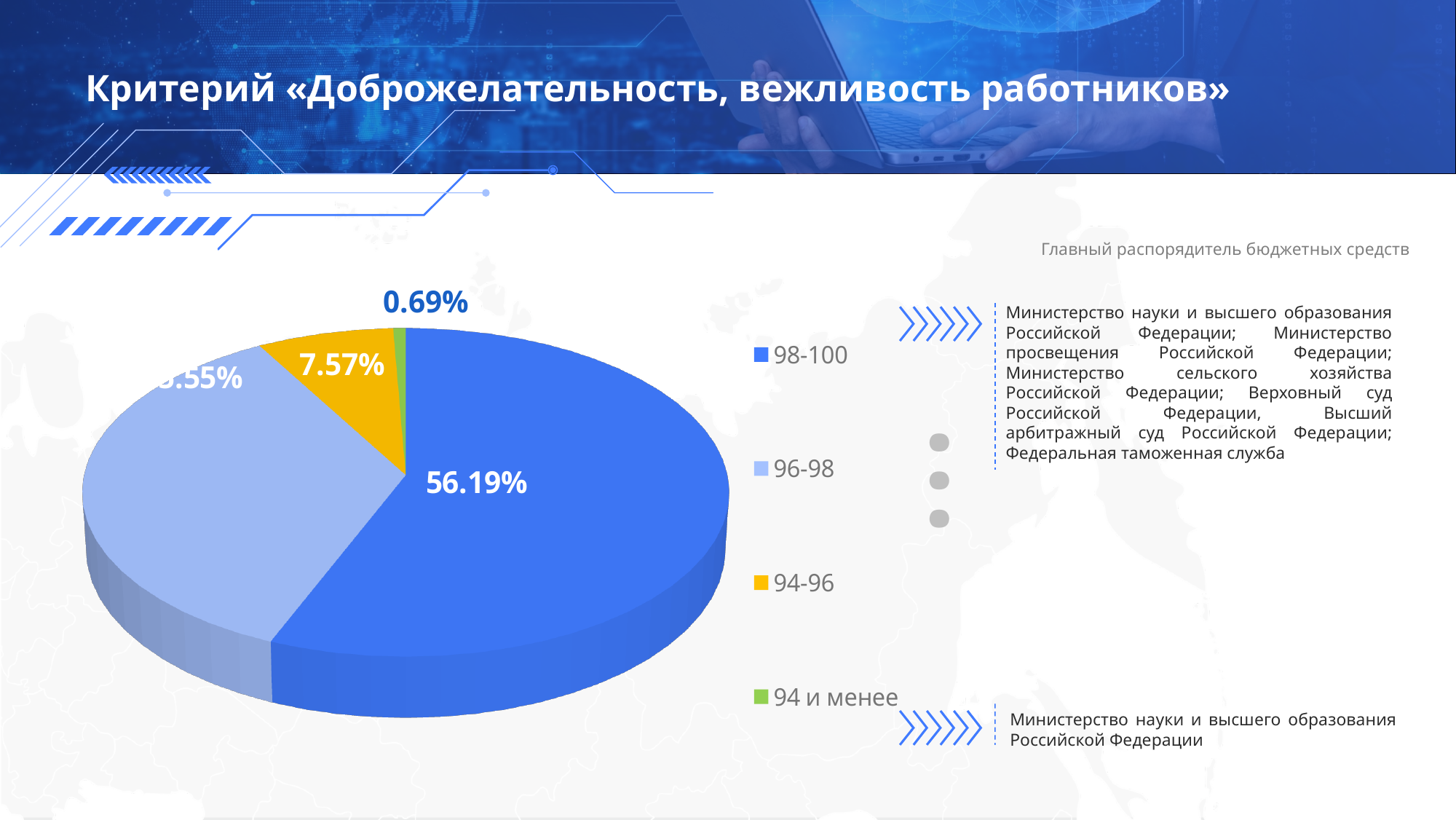
What kind of chart is shown on the slide? pie chart How many categories does the legend list? 4 What is the difference between the 94-96 share and the "94 и менее" share? 6.88% Which category has the largest slice of the pie? 98-100 Which is larger, the slice for 96-98 or the slice for 94-96? 96-98 What share of the pie does the 98-100 category have? 56.19% What colour is the slice for the 94-96 category? yellow What share of the pie does the "94 и менее" category have? 0.69% What share of the pie does the 94-96 category have? 7.57% Which category has the smallest slice of the pie? 94 и менее What is the difference between the 98-100 share and the 94-96 share? 48.62% Which is larger, the slice for 94-96 or the slice for "94 и менее"? 94-96